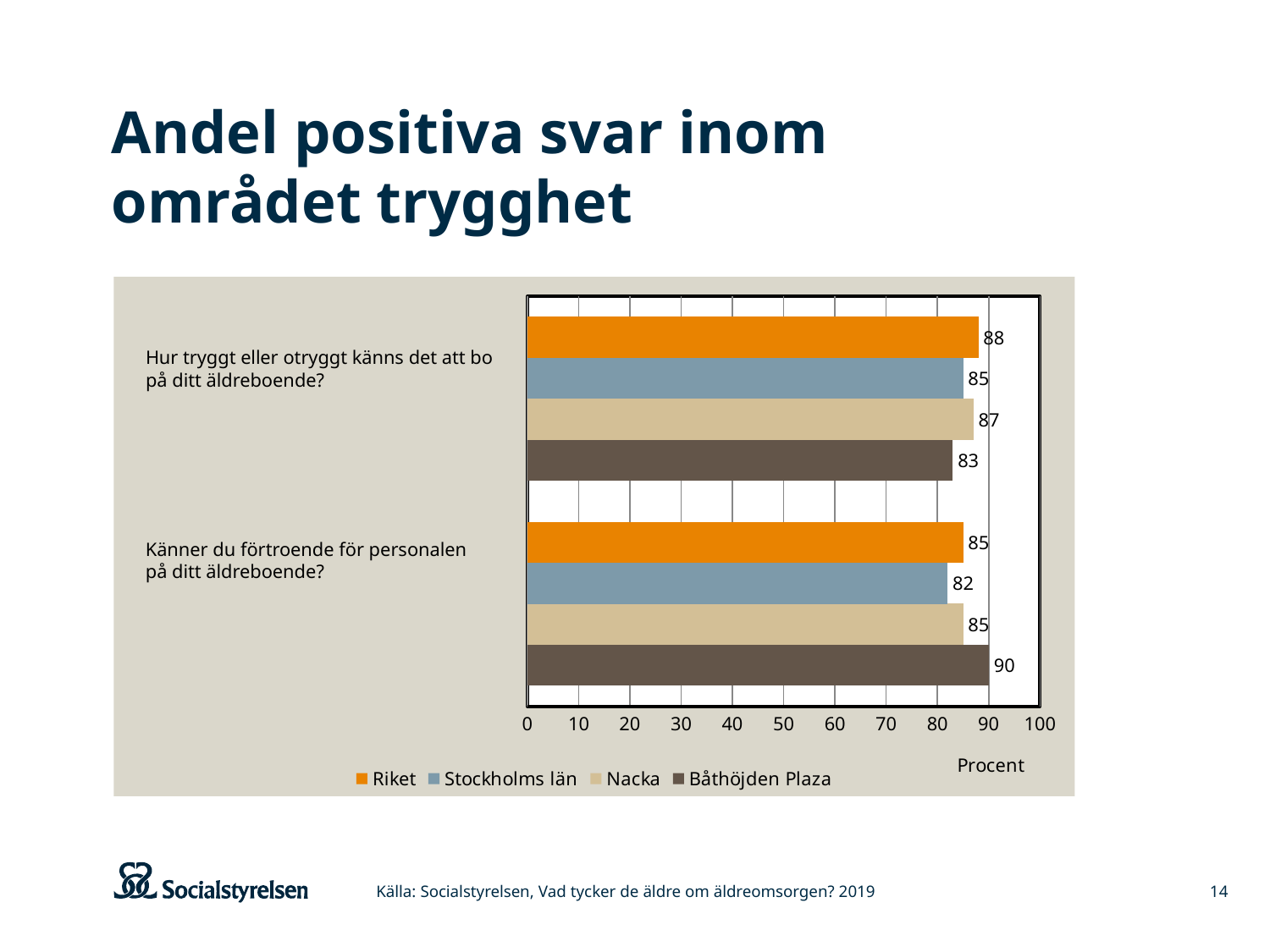
How many series does the legend list? 4 Which series has the highest value for the question "Känner du förtroende för personalen på ditt äldreboende?"? Båthöjden Plaza What is the value for Nacka for the question "Hur tryggt eller otryggt känns det att bo på ditt äldreboende?"? 87 What unit is shown on the horizontal axis of the chart? Procent What kind of chart is shown on the slide? Bar chart Which series has the lowest value for the question "Hur tryggt eller otryggt känns det att bo på ditt äldreboende?"? Båthöjden Plaza What is the difference between the Riket value and the Båthöjden Plaza value for the question "Hur tryggt eller otryggt känns det att bo på ditt äldreboende?"? 5 How many questions (categories) are shown on the chart? 2 What is the value for Båthöjden Plaza for the question "Känner du förtroende för personalen på ditt äldreboende?"? 90 What is the value for Stockholms län for the question "Känner du förtroende för personalen på ditt äldreboende?"? 82 For the question "Känner du förtroende för personalen på ditt äldreboende?", which is larger: the value for Riket or the value for Stockholms län? Riket What is the value for Riket for the question "Hur tryggt eller otryggt känns det att bo på ditt äldreboende?"? 88